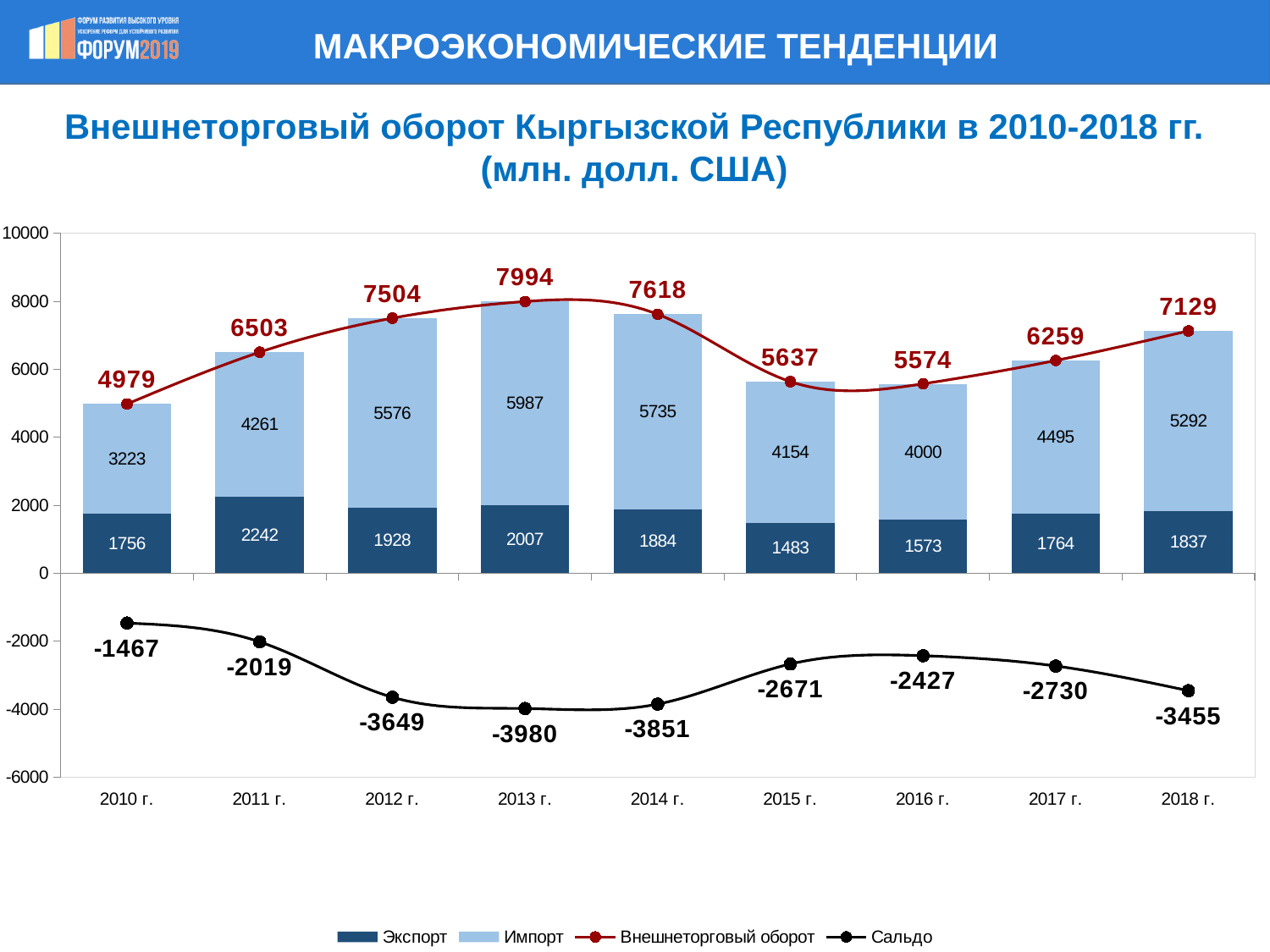
How many years are shown on the x axis? 9 How many series does the legend list? 4 By how much did Импорт increase from 2017 г. to 2018 г.? 797 Does Сальдо rise or fall from 2010 г. to 2013 г.? Falls In which year is Экспорт the lowest? 2015 г. What is the total of the stacked bar (Экспорт plus Импорт) for 2010 г.? 4979 Which year has the larger Экспорт value, 2010 г. or 2011 г.? 2011 г. What kind of chart is this? Stacked bar chart combined with line charts In which year is Внешнеторговый оборот the highest? 2013 г. What is the value of Экспорт for 2015 г.? 1483 What is the value of Импорт for 2013 г.? 5987 What is the value of Сальдо for 2012 г.? -3649